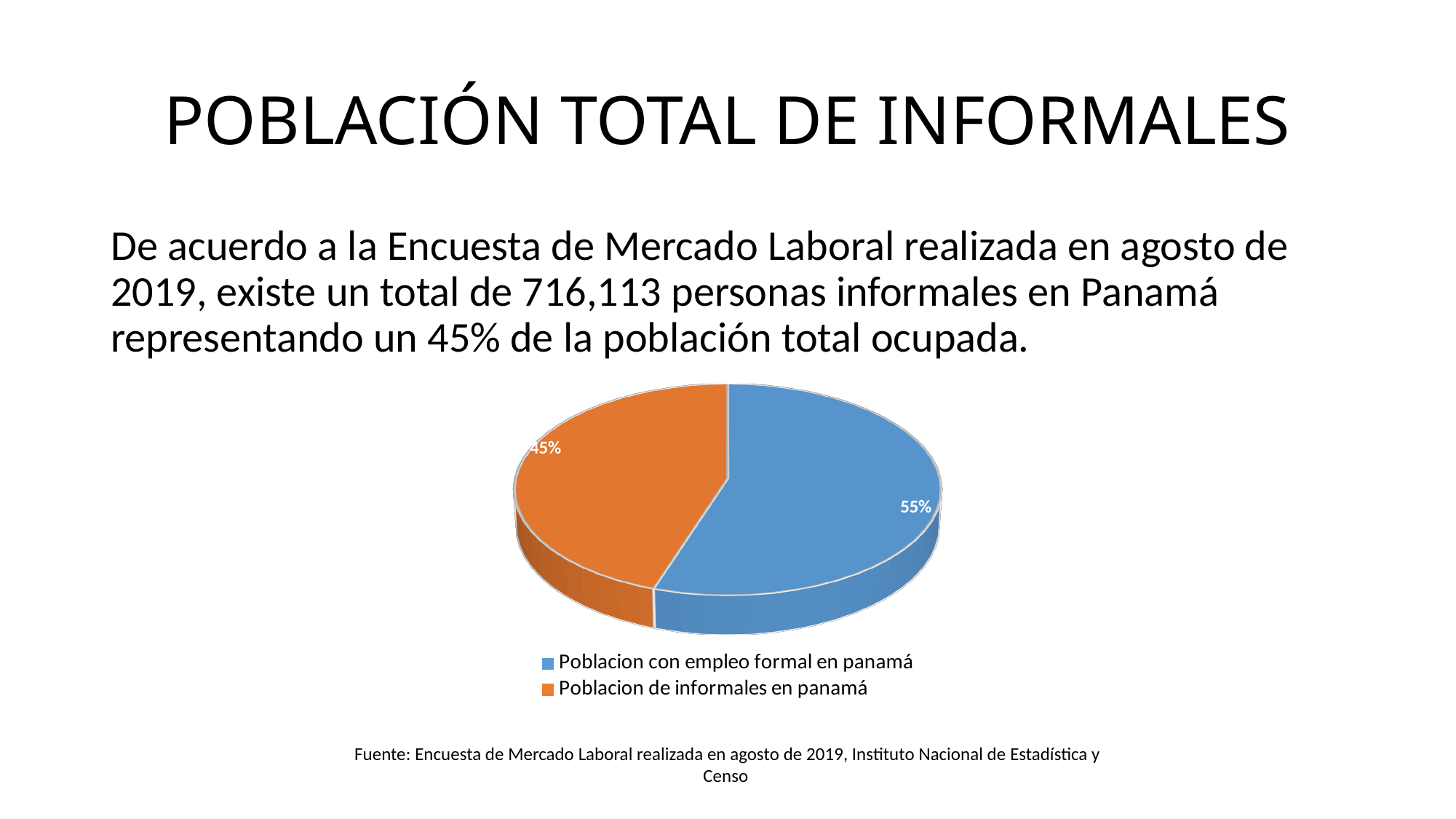
What share of the pie does 'Poblacion con empleo formal en panamá' represent? 55% What is the difference in percentage points between the formal employment slice and the informal slice? 10% Which is larger: the share for 'Poblacion con empleo formal en panamá' or the share for 'Poblacion de informales en panamá'? Poblacion con empleo formal en panamá Which slice of the pie is the largest? Poblacion con empleo formal en panamá What colour is the slice for 'Poblacion con empleo formal en panamá'? Blue What kind of chart is shown on the slide? Pie chart What share of the pie does 'Poblacion de informales en panamá' represent? 45% Which slice of the pie is the smallest? Poblacion de informales en panamá How many slices does the pie chart have? 2 What colour is the slice for 'Poblacion de informales en panamá'? Orange How many entries does the legend list? 2